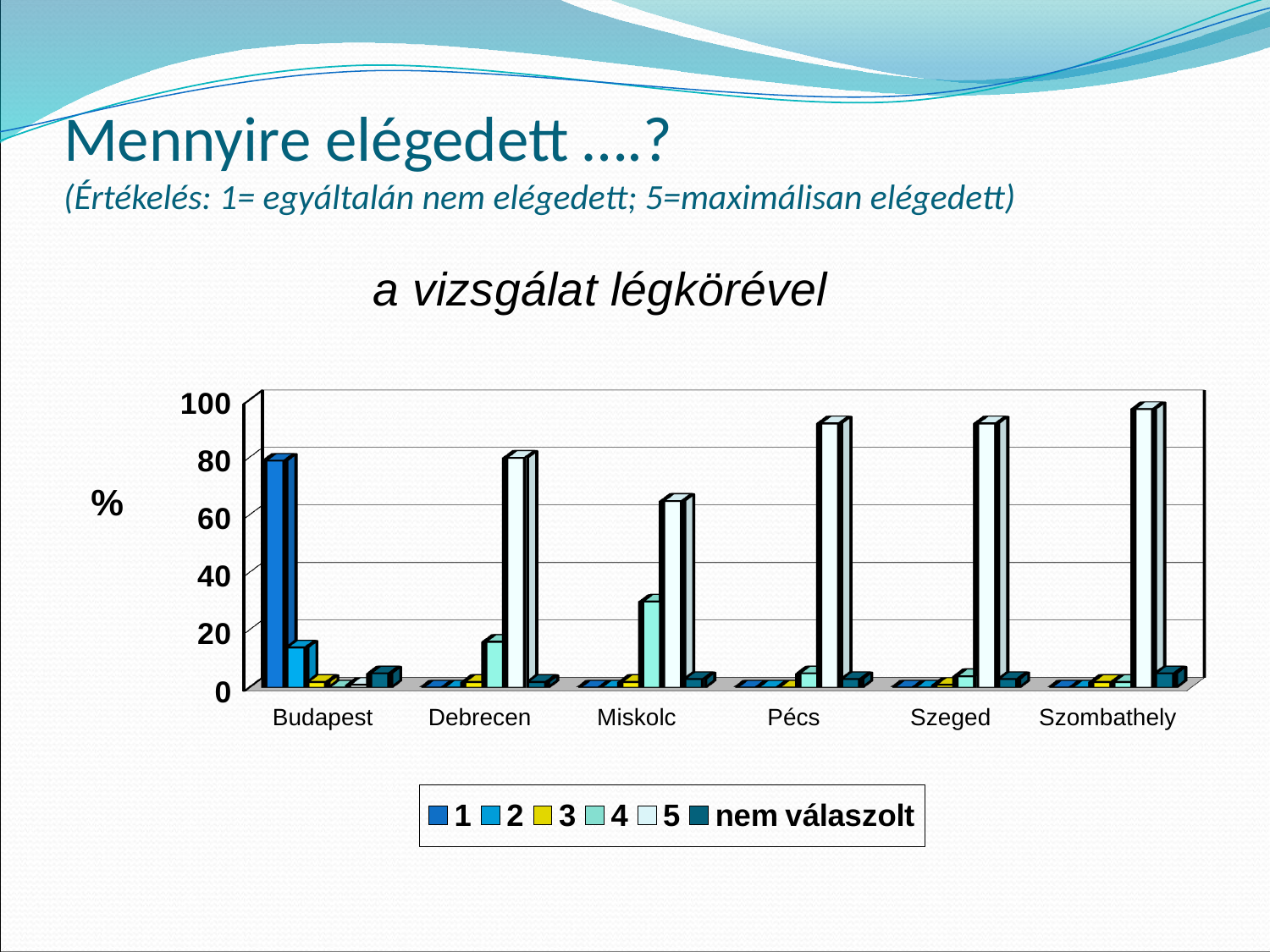
Which city has the lowest value for series 5? Budapest Is the value for series 4 in Miskolc greater or less than 20? greater What is the label on the vertical axis of the chart? % Is the value for series 1 in Budapest greater or less than 60? greater Is the value for series 5 in Szombathely greater or less than 80? greater What kind of chart is shown on the slide? bar chart Which is larger: the value for series 5 in Debrecen or the value for series 5 in Miskolc? Debrecen How many series does the chart's legend list? 6 In Budapest, which is larger: the value for series 1 or the value for series 2? series 1 What is the last entry listed in the chart's legend? nem válaszolt How many cities are shown on the x axis of the chart? 6